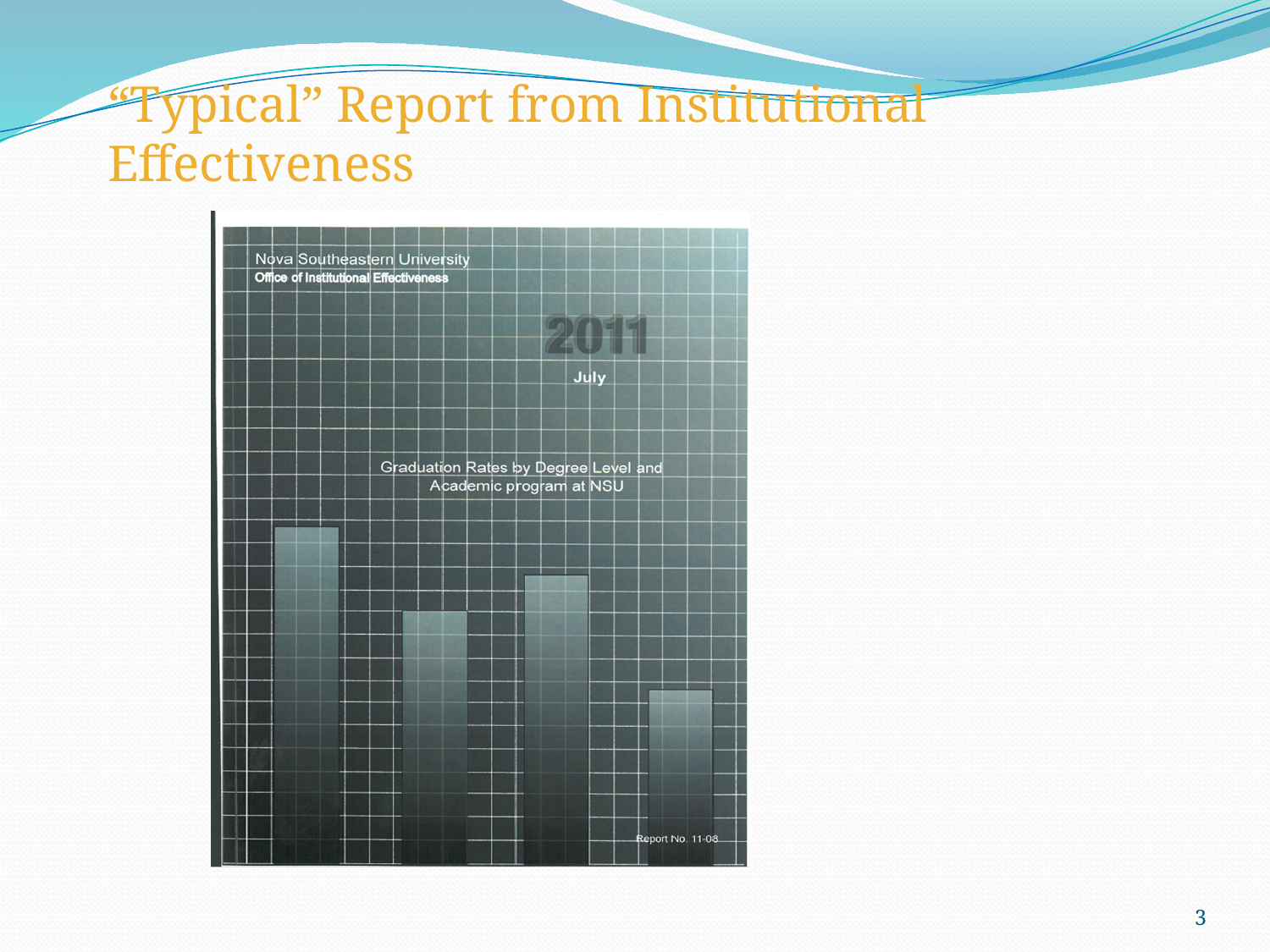
Which bar on the report cover chart is the tallest? The leftmost bar How many bars does the chart on the report cover have? 4 Which office produced the report whose cover chart is shown? Office of Institutional Effectiveness On the report cover chart, is the leftmost bar taller or shorter than the rightmost bar? Taller What is the title printed above the chart on the report cover? Graduation Rates by Degree Level and Academic program at NSU Which bar on the report cover chart is the shortest? The rightmost bar What kind of chart is shown on the report cover? Bar chart On the report cover chart, is the second bar from the left taller or shorter than the third bar from the left? Shorter